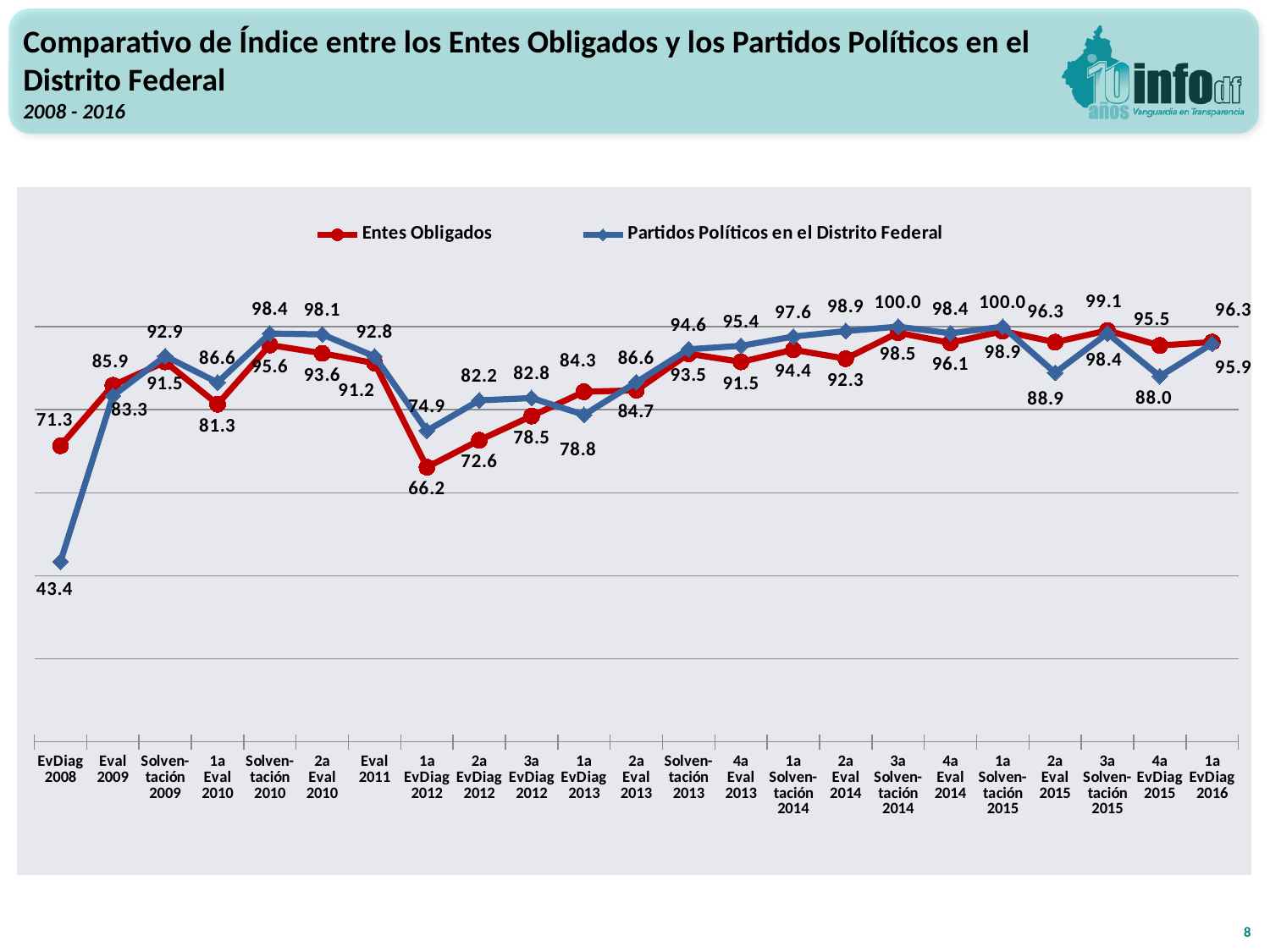
At Solventación 2010, which series has the higher value, Entes Obligados or Partidos Políticos en el Distrito Federal? Partidos Políticos en el Distrito Federal What type of chart is shown on the slide? Line chart What is the difference between Entes Obligados and Partidos Políticos en el Distrito Federal at EvDiag 2008? 27.9 At which category does the Partidos Políticos en el Distrito Federal series reach its lowest value? EvDiag 2008 What is the value for Entes Obligados at EvDiag 2008? 71.3 At which category does the Entes Obligados series reach its highest value? 3a Solventación 2015 What is the value for Partidos Políticos en el Distrito Federal at 2a Eval 2015? 88.9 At which category does the Entes Obligados series reach its lowest value? 1a EvDiag 2012 What is the difference between Entes Obligados and Partidos Políticos en el Distrito Federal at 4a EvDiag 2015? 7.5 How many series does the legend list? 2 How many categories are plotted along the x axis? 23 What is the value for Partidos Políticos en el Distrito Federal at EvDiag 2008? 43.4